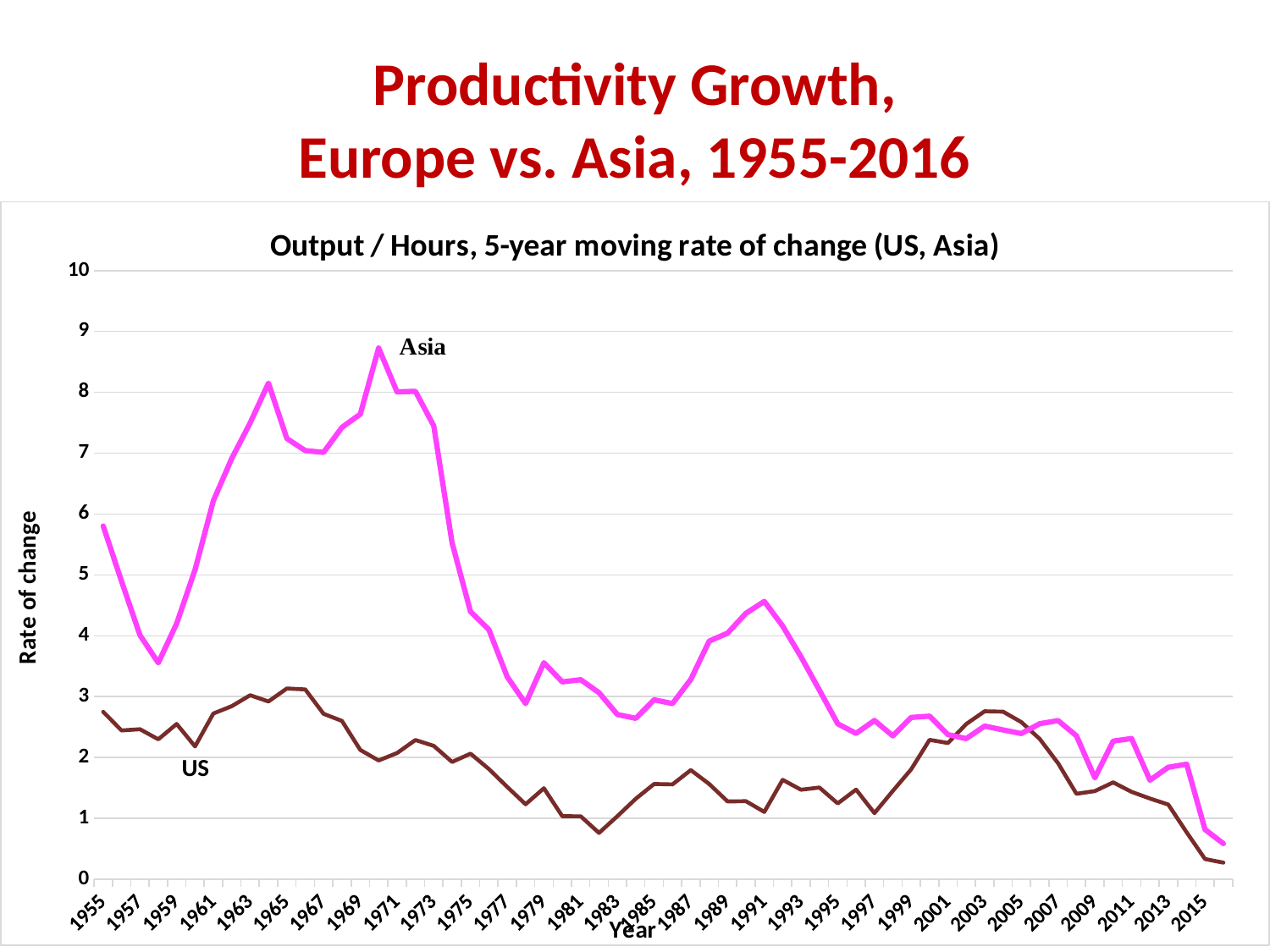
What is the label on the vertical axis? Rate of change What kind of chart is shown on the slide? line chart Is the value for Asia in 1991 greater or less than 4? greater Does the Asia line rise or fall between 1971 and 1978? fall What is the title printed inside the chart area? Output / Hours, 5-year moving rate of change (US, Asia) Is the value for the US in 2016 greater or less than 1? less In 2003, which series has the higher value, Asia or the US? US How many lines (series) are plotted on the chart? 2 In 1971, which series has the higher value, Asia or the US? Asia Is the value for Asia in 1955 greater or less than 5? greater